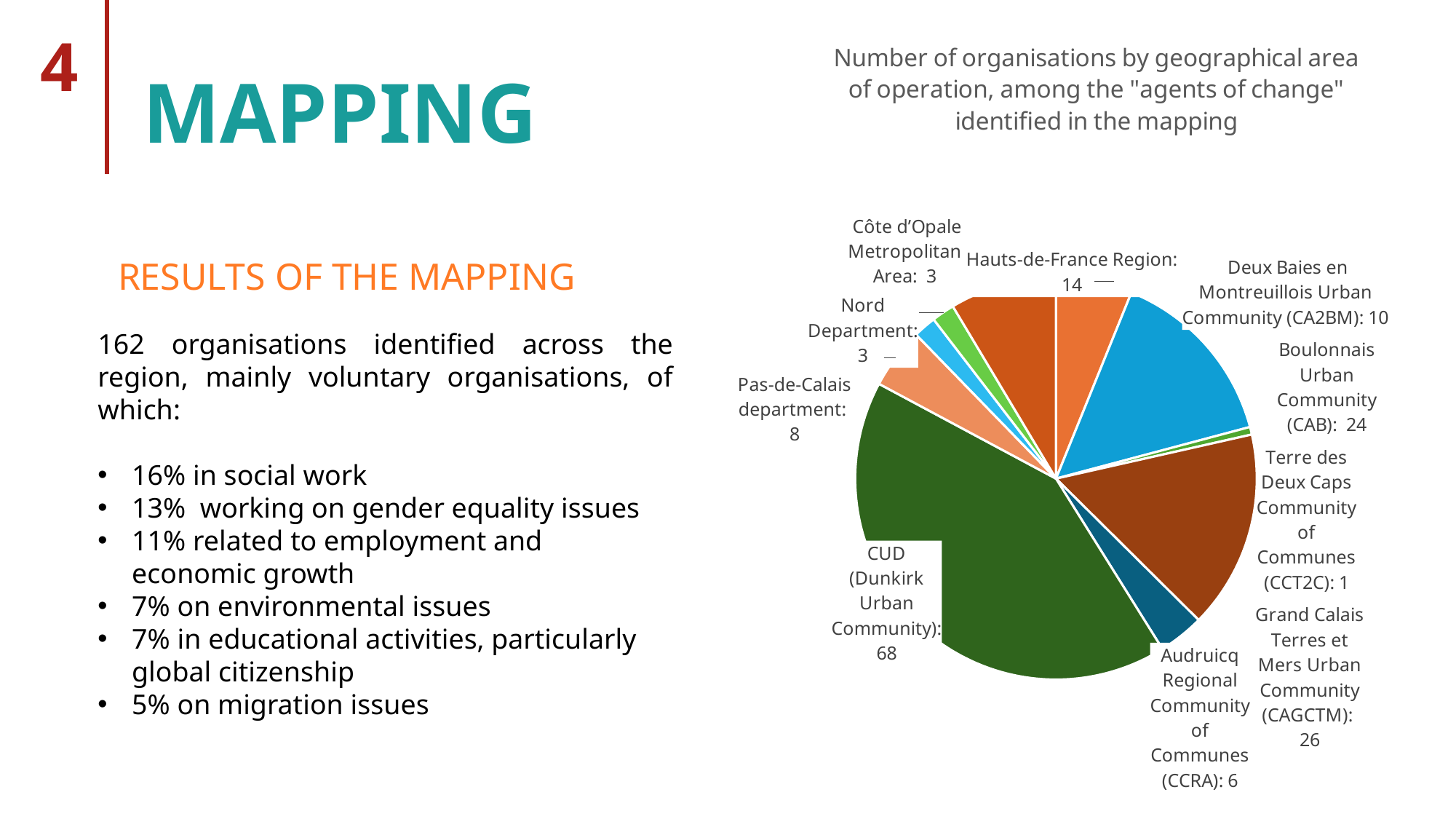
What is the title of the pie chart? Number of organisations by geographical area of operation, among the "agents of change" identified in the mapping What is the number of organisations for the Hauts-de-France Region in the pie chart? 14 What is the difference between the number of organisations for the Boulonnais Urban Community (CAB) and the Deux Baies en Montreuillois Urban Community (CA2BM)? 14 How many organisations are shown for the Boulonnais Urban Community (CAB)? 24 What is the difference between the number of organisations in the CUD (Dunkirk Urban Community) and in the Grand Calais Terres et Mers Urban Community (CAGCTM)? 42 What value is shown for the Pas-de-Calais department in the pie chart? 8 Which geographical area has the smallest number of organisations in the pie chart? Terre des Deux Caps Community of Communes (CCT2C) Which geographical area has the largest number of organisations in the pie chart? CUD (Dunkirk Urban Community) How many organisations operate in the CUD (Dunkirk Urban Community) according to the pie chart? 68 What type of chart is shown on the slide? Pie chart How many geographical areas are shown as slices in the pie chart? 10 Which has more organisations: the Grand Calais Terres et Mers Urban Community (CAGCTM) or the Boulonnais Urban Community (CAB)? Grand Calais Terres et Mers Urban Community (CAGCTM)